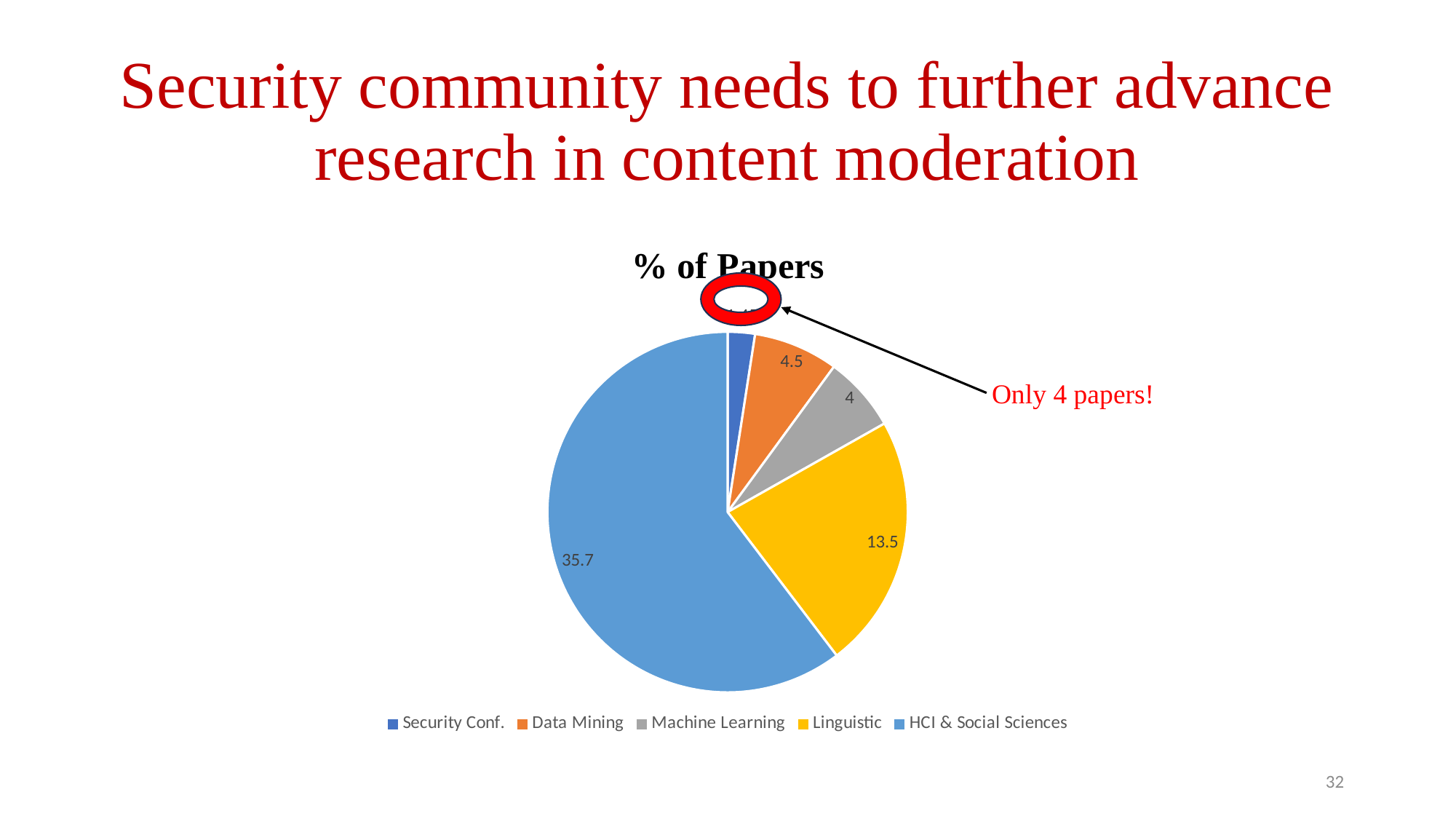
How many categories does the legend list? 5 What value is shown for the Linguistic slice? 13.5 Which category has the smallest slice of the pie? Security Conf. What does the red annotation pointing at the circled slice say? Only 4 papers! Which category has the largest slice of the pie? HCI & Social Sciences What is the difference between the HCI & Social Sciences value and the Linguistic value? 22.2 What value is shown for the Machine Learning slice? 4 What value is shown for the Data Mining slice? 4.5 What is the title of the chart? % of Papers Which is larger, the Linguistic slice or the Data Mining slice? Linguistic What value is shown for the HCI & Social Sciences slice? 35.7 What kind of chart is shown on the slide? pie chart